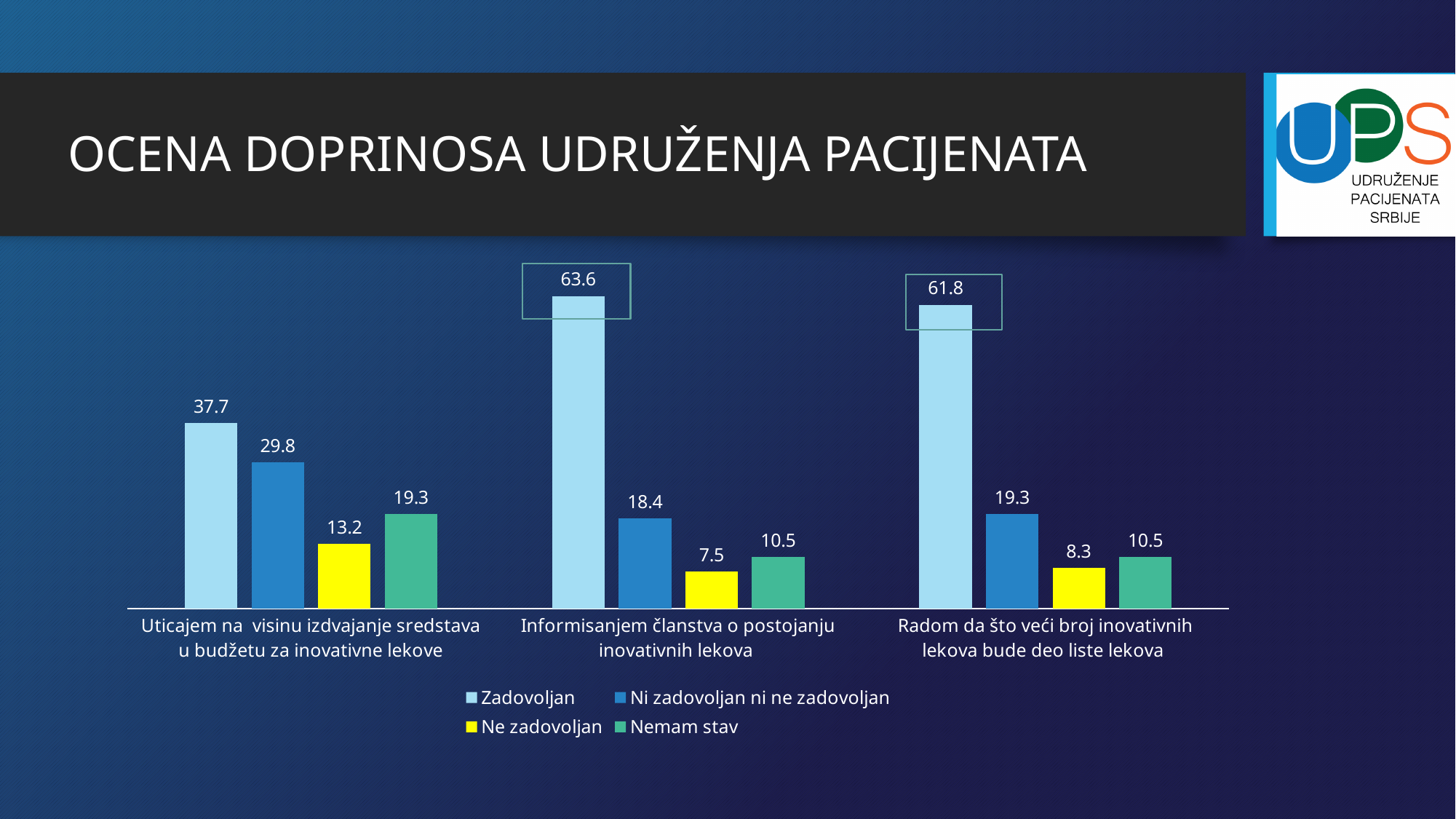
What is the difference between the "Zadovoljan" values for "Informisanjem članstva o postojanju inovativnih lekova" and "Radom da što veći broj inovativnih lekova bude deo liste lekova"? 1.8 How many categories are shown on the x axis? 3 What is the value for "Zadovoljan" in the category "Informisanjem članstva o postojanju inovativnih lekova"? 63.6 What is the value for "Ne zadovoljan" in the category "Radom da što veći broj inovativnih lekova bude deo liste lekova"? 8.3 How many series does the legend list? 4 Which category has the lowest "Ne zadovoljan" value? Informisanjem članstva o postojanju inovativnih lekova What is the value for "Ni zadovoljan ni ne zadovoljan" in the category "Uticajem na visinu izdvajanje sredstava u budžetu za inovativne lekove"? 29.8 What kind of chart is shown on the slide? Bar chart Which category has the highest "Zadovoljan" value? Informisanjem članstva o postojanju inovativnih lekova Which is larger: the "Nemam stav" value for "Uticajem na visinu izdvajanje sredstava u budžetu za inovativne lekove" or the "Ni zadovoljan ni ne zadovoljan" value for "Informisanjem članstva o postojanju inovativnih lekova"? Nemam stav for Uticajem na visinu izdvajanje sredstava u budžetu za inovativne lekove What is the value for "Nemam stav" in the category "Informisanjem članstva o postojanju inovativnih lekova"? 10.5 What is the title of the slide containing the chart? OCENA DOPRINOSA UDRUŽENJA PACIJENATA